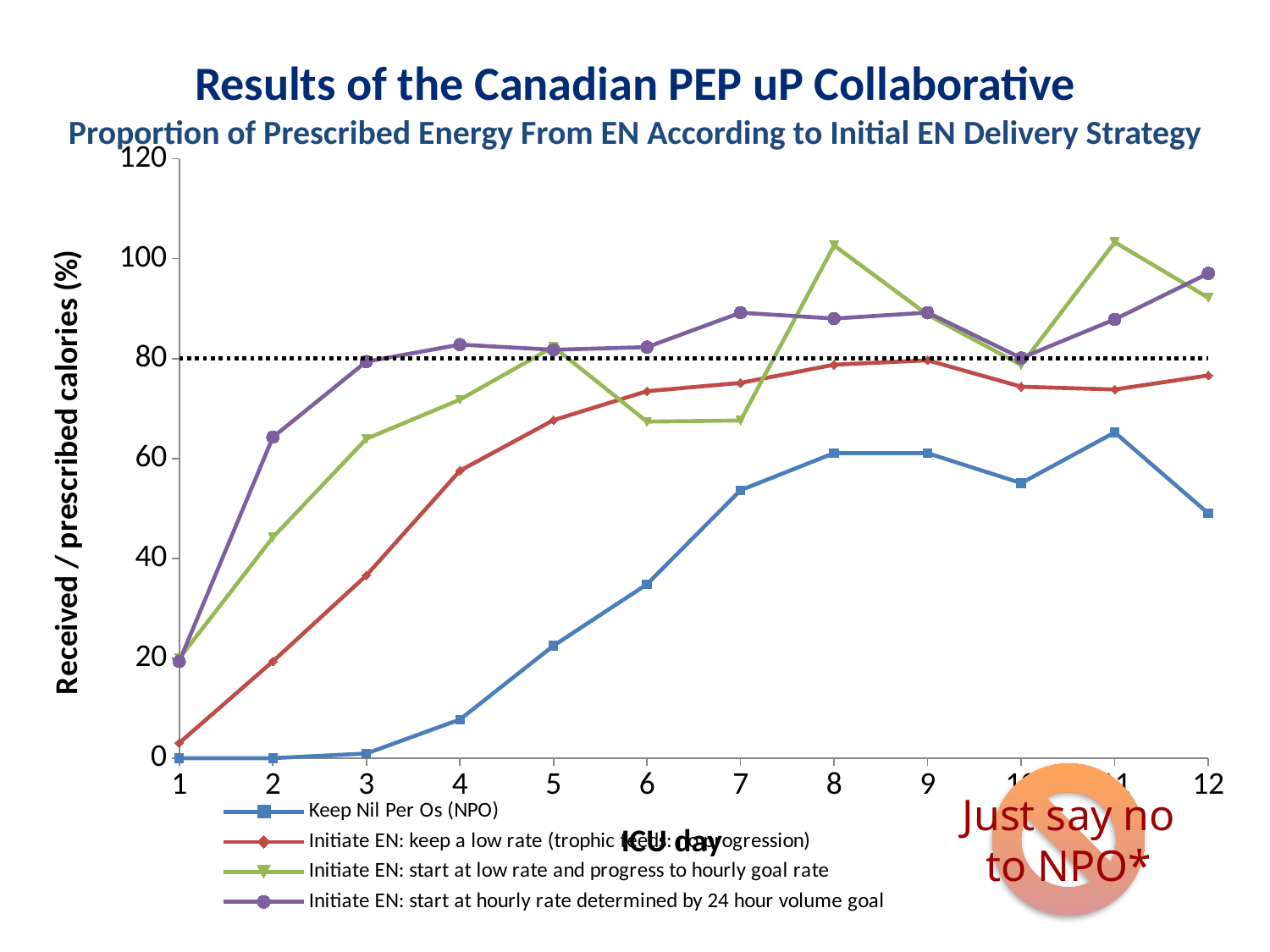
How many series does the legend list? 4 Is the value for the 'Initiate EN: start at low rate and progress to hourly goal rate' series on ICU day 8 greater or less than 80? greater Is the value for the Keep Nil Per Os (NPO) series on ICU day 8 greater or less than 80? less What is the value for the Keep Nil Per Os (NPO) series on ICU day 1? 0 How many ICU days are plotted along the x axis? 12 On ICU day 12, which series has the higher value: Keep Nil Per Os (NPO) or 'Initiate EN: start at hourly rate determined by 24 hour volume goal'? Initiate EN: start at hourly rate determined by 24 hour volume goal Which series has the lowest value on ICU day 5? Keep Nil Per Os (NPO) On ICU day 4, which series has the higher value: 'Initiate EN: keep a low rate' or 'Initiate EN: start at low rate and progress to hourly goal rate'? Initiate EN: start at low rate and progress to hourly goal rate What kind of chart is shown on the slide? line chart Does the Keep Nil Per Os (NPO) series rise or fall from ICU day 1 to ICU day 8? rise Is the value for the 'Initiate EN: start at hourly rate determined by 24 hour volume goal' series on ICU day 3 greater or less than 60? greater Which series has the highest value on ICU day 2? Initiate EN: start at hourly rate determined by 24 hour volume goal